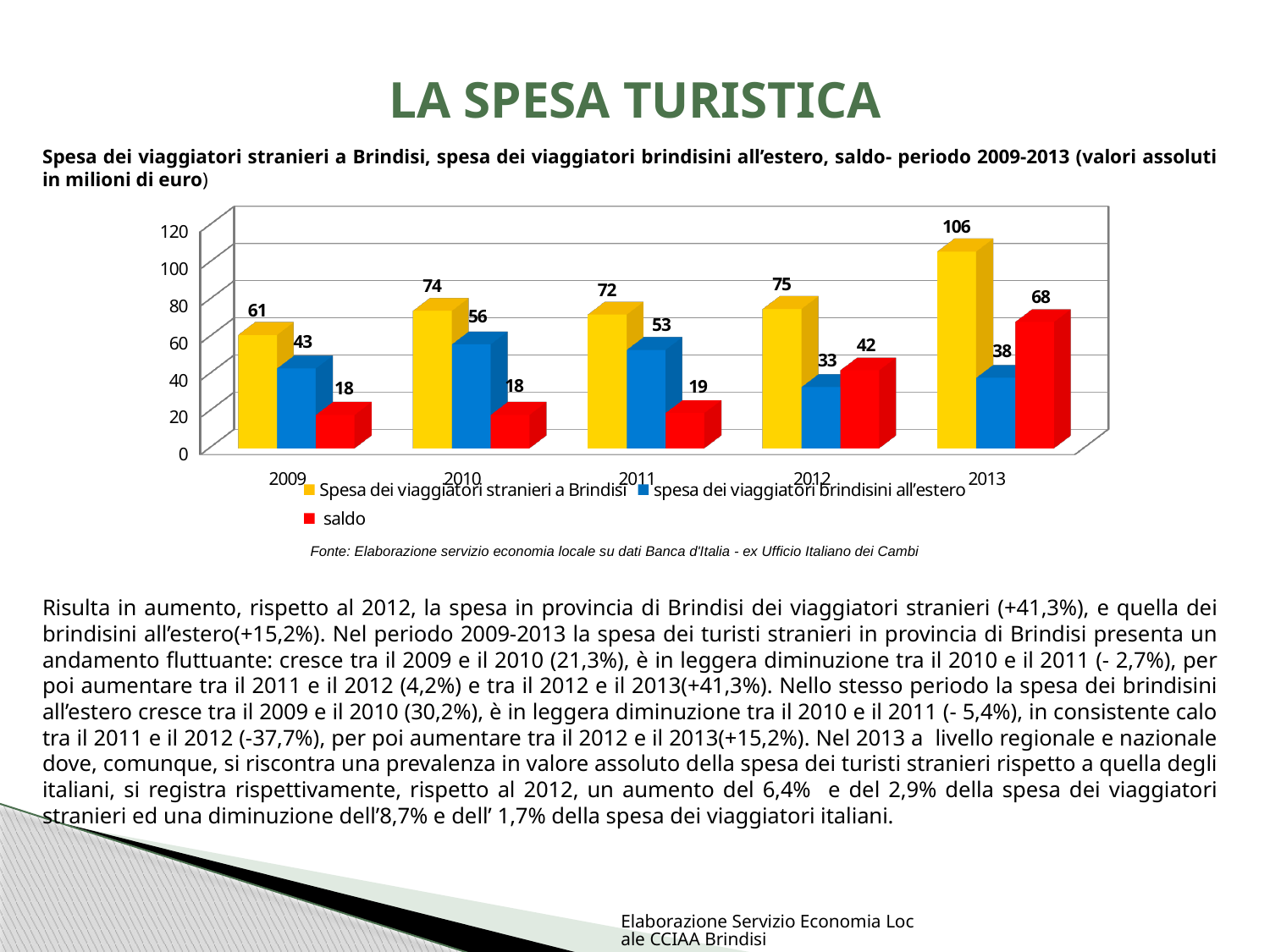
Does the 'saldo' series rise or fall from 2011 to 2013? rise What is the value of 'Spesa dei viaggiatori stranieri a Brindisi' in 2013? 106 How many years are shown on the x axis? 5 In which year is 'Spesa dei viaggiatori stranieri a Brindisi' highest? 2013 How many series does the legend list? 3 What is the 'saldo' value for 2012? 42 In which year is 'spesa dei viaggiatori brindisini all'estero' lowest? 2012 What kind of chart is shown on the slide? bar chart Which is larger in 2009: 'spesa dei viaggiatori brindisini all'estero' or 'saldo'? spesa dei viaggiatori brindisini all'estero What is the value of 'spesa dei viaggiatori brindisini all'estero' in 2010? 56 What is the difference between 'Spesa dei viaggiatori stranieri a Brindisi' and 'spesa dei viaggiatori brindisini all'estero' in 2011? 19 What colour represents 'saldo' in the chart? red